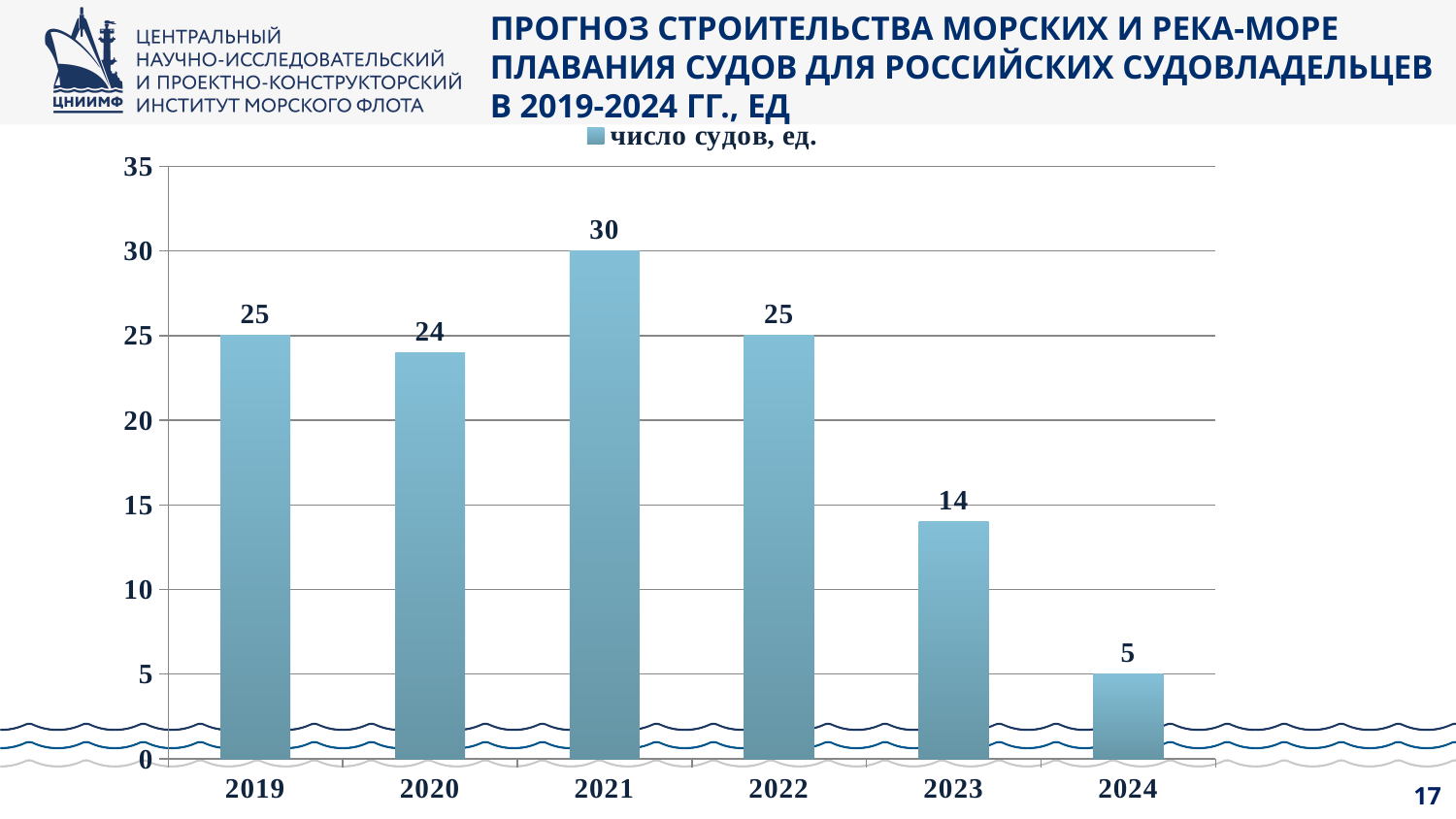
What kind of chart is shown on the slide? bar chart What is the difference between the values for 2021 and 2023? 16 Do the values rise or fall from 2022 to 2024? fall What is the value shown for 2020? 24 How many years are shown on the x axis? 6 Which year has the lowest number of vessels? 2024 How many series does the legend list? 1 What is the difference between the values for 2022 and 2024? 20 Which is larger, the value for 2020 or the value for 2023? 2020 What is the number of vessels forecast for 2024? 5 What is the number of vessels forecast for 2021? 30 Which year has the highest number of vessels? 2021